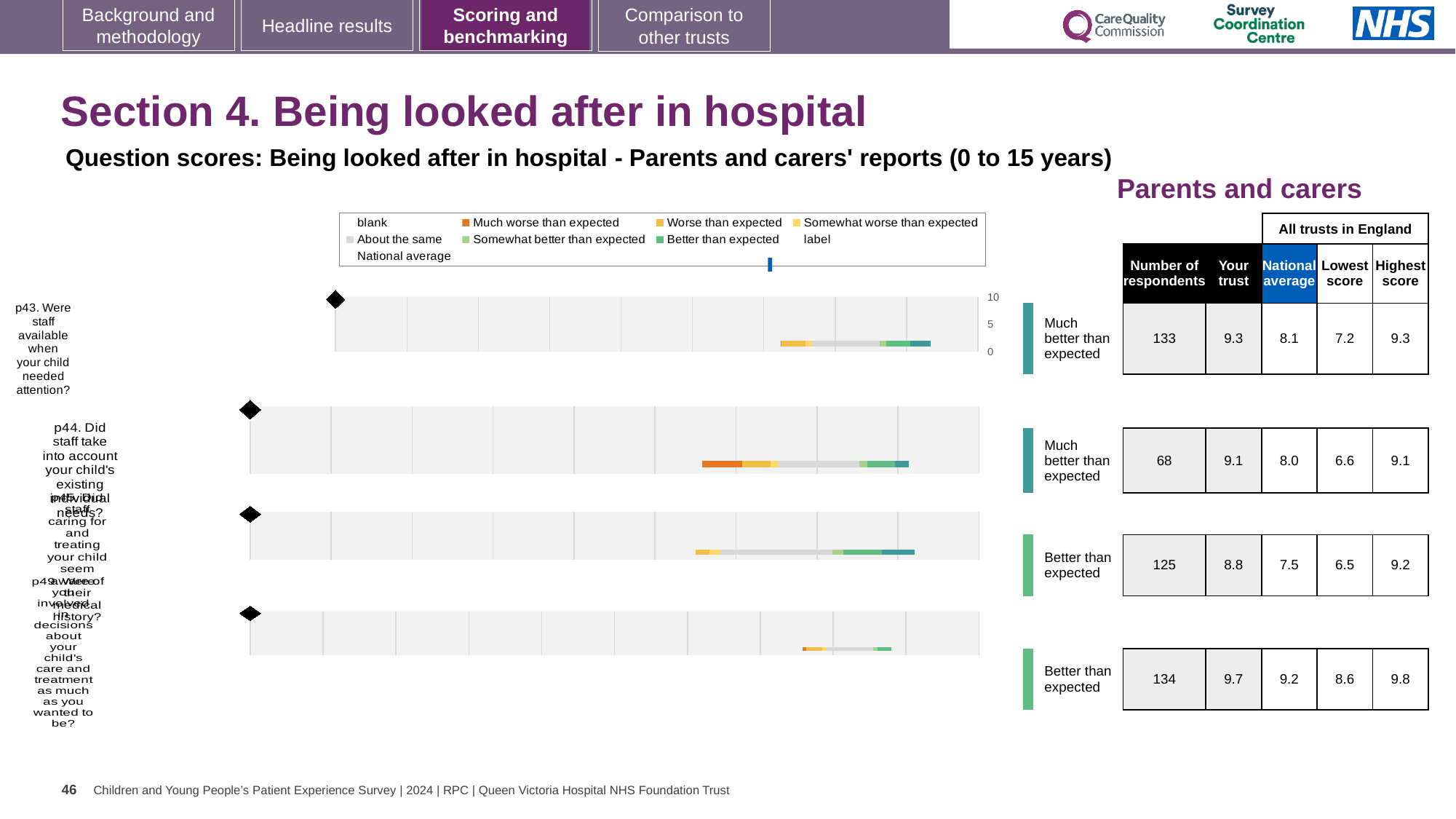
For the first chart (p43), what is the difference between the 'Your trust' score and the National average? 1.2 For the third chart (p45), what is the Highest score shown in the table? 9.2 Which question has the lowest 'Your trust' score in the table? p45 What kind of chart is used for each question on this slide? bar chart For the first chart (p43), how many respondents are shown in the table? 133 How many question charts are shown on the slide? 4 For the second chart (p44), what is the National average score shown in the table? 8.0 For the fourth chart (p49), what is the Lowest score shown in the table? 8.6 For the first chart (p43, Were staff available when your child needed attention?), what is the 'Your trust' score shown in the table? 9.3 What benchmark category is shown next to the first chart (p43)? Much better than expected Which has the larger 'Your trust' score, p44 or p45? p44 Which question has the highest 'Your trust' score in the table? p49